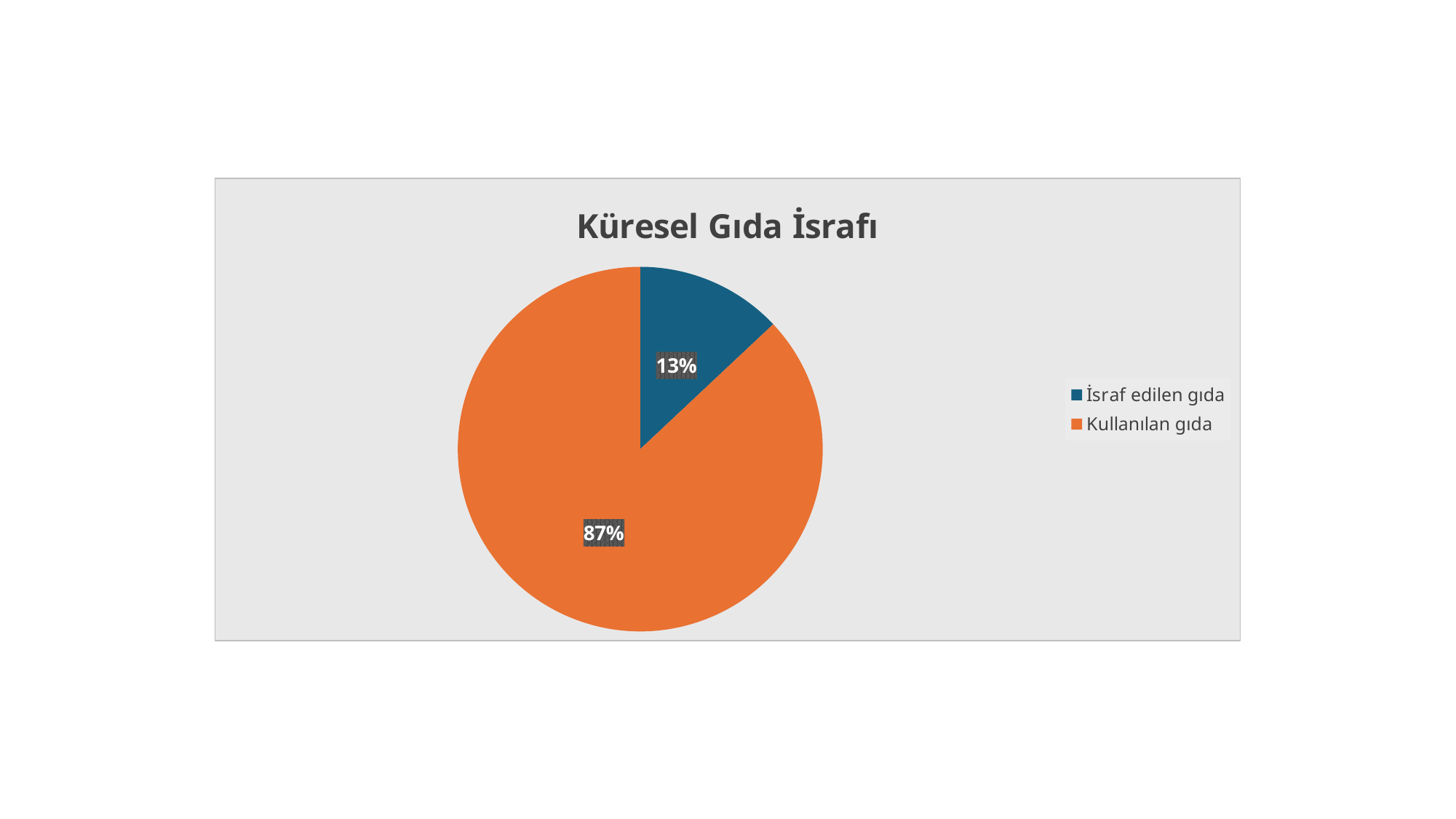
Which is larger, the slice for 'İsraf edilen gıda' or the slice for 'Kullanılan gıda'? Kullanılan gıda What is the value printed on the orange slice? 87% Which category has the largest slice of the pie? Kullanılan gıda How many categories does the legend list? 2 What share of the pie does 'Kullanılan gıda' represent? 87% Which category has the smallest slice of the pie? İsraf edilen gıda What is the title of the chart? Küresel Gıda İsrafı What colour is the slice for 'İsraf edilen gıda'? blue What kind of chart is shown on the slide? pie chart What is the difference in percentage points between 'Kullanılan gıda' and 'İsraf edilen gıda'? 74 What share of the pie does 'İsraf edilen gıda' represent? 13%